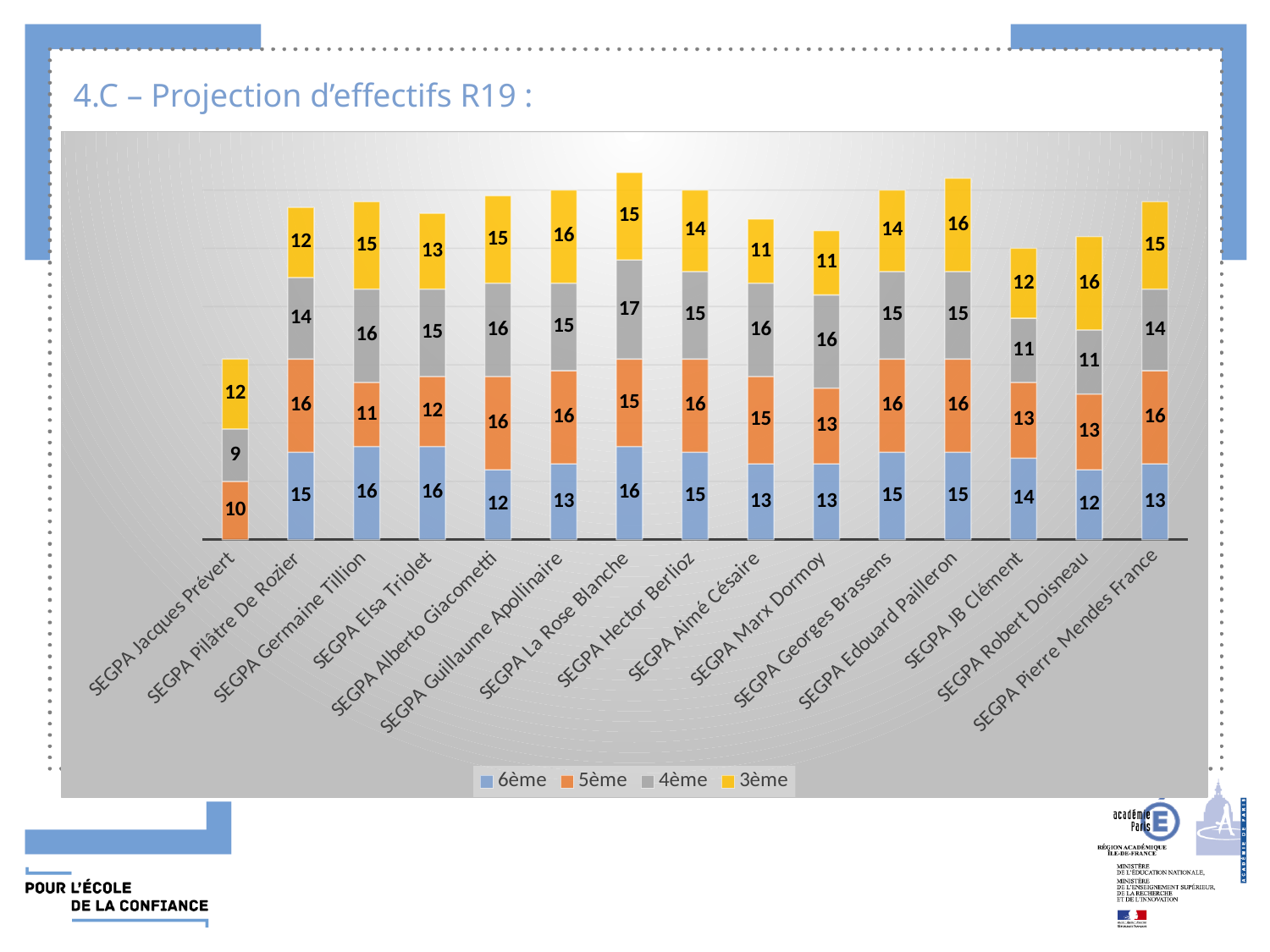
What is the 6ème value for SEGPA Alberto Giacometti? 12 Which SEGPA has the tallest stacked bar overall? SEGPA La Rose Blanche What is the total of the stacked bar for SEGPA Jacques Prévert? 31 What is the 4ème value for SEGPA Jacques Prévert? 9 What is the 5ème value for SEGPA Germaine Tillion? 11 Which is larger: the 4ème value for SEGPA La Rose Blanche or the 4ème value for SEGPA Pierre Mendes France? SEGPA La Rose Blanche What is the difference between the 3ème value for SEGPA Robert Doisneau and the 3ème value for SEGPA JB Clément? 4 How many SEGPA categories are shown on the x axis? 15 What is the 3ème value for SEGPA La Rose Blanche? 15 Which SEGPA has the shortest stacked bar overall? SEGPA Jacques Prévert How many series does the legend list? 4 What is the total of the stacked bar for SEGPA La Rose Blanche? 63